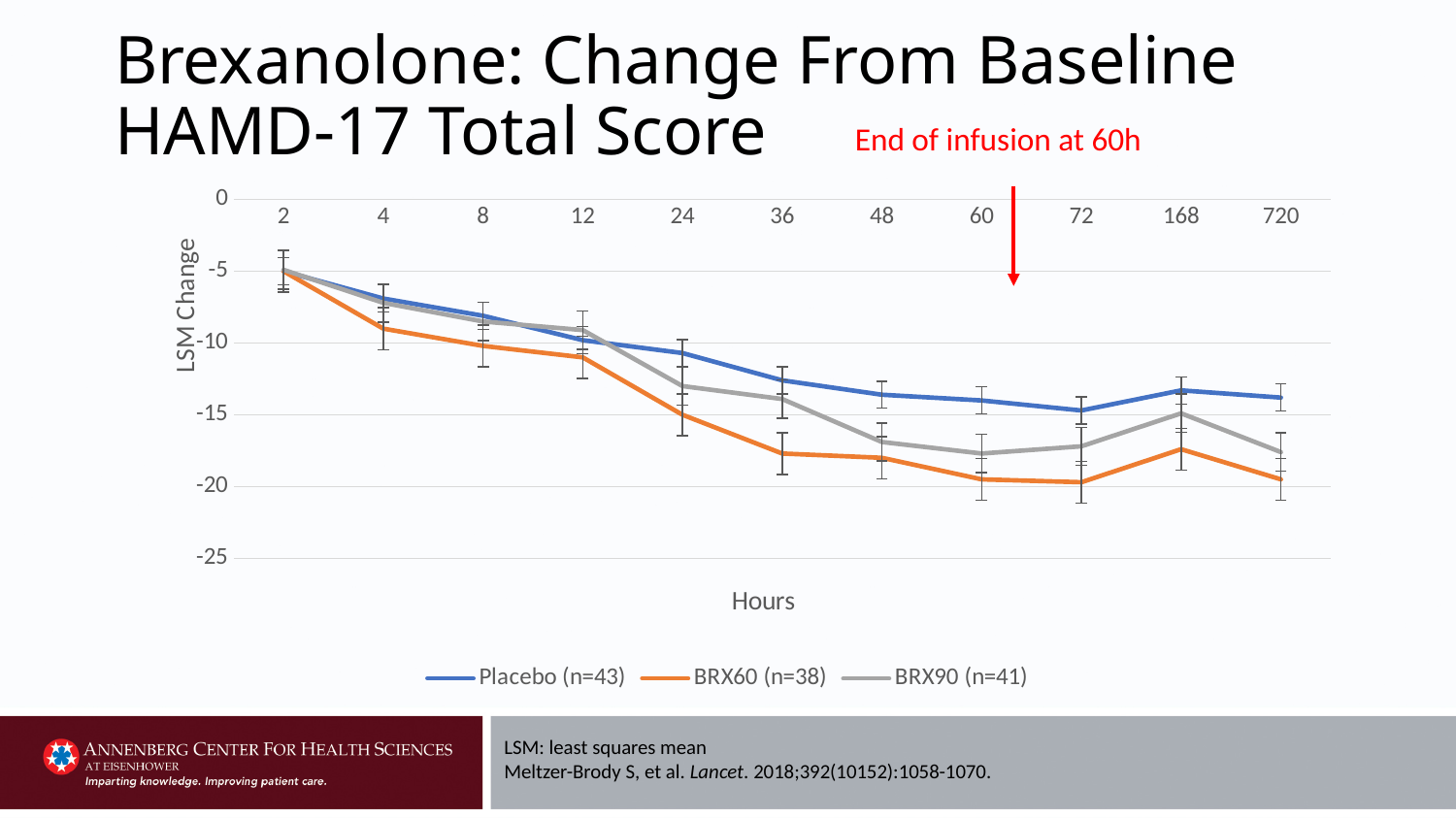
What is the title of the x axis? Hours How many series does the legend list? 3 Which series has the highest (least negative) value at 60 hours? Placebo (n=43) Do the Placebo (n=43) values rise or fall from 2 hours to 72 hours? fall Which series has the lowest (most negative) value at 72 hours? BRX60 (n=38) Is the value for BRX90 (n=41) at 48 hours greater or less than -15? less Is the value for Placebo (n=43) at 720 hours greater or less than -15? greater What kind of chart is shown on the slide? Line chart Is the value for BRX60 (n=38) at 60 hours greater or less than -15? less At 36 hours, which series has the larger (less negative) LSM change, Placebo (n=43) or BRX60 (n=38)? Placebo (n=43) At 168 hours, which series has the larger (less negative) LSM change, Placebo (n=43) or BRX90 (n=41)? Placebo (n=43) How many time points are plotted along the x axis? 11